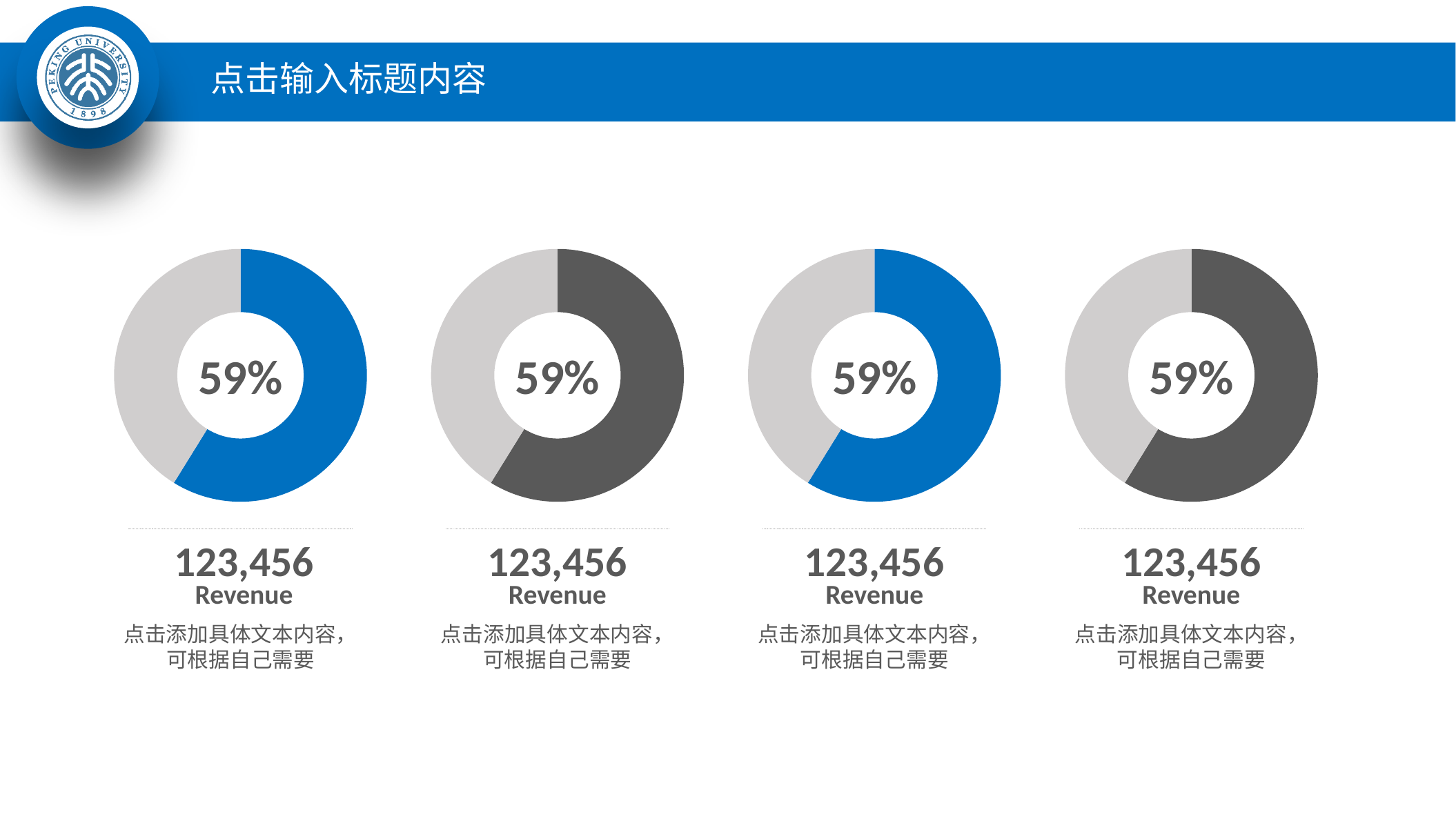
Do the four donut charts show the same percentage or different percentages? The same (59%) What percentage is shown in the centre of the second donut chart from the left? 59% How many donut charts are on the slide? 4 In the leftmost donut chart, is the highlighted share greater or less than 50%? greater What colour is the highlighted segment in the leftmost donut chart? Blue What kind of chart is used four times across the slide? Donut chart What revenue figure is printed below the leftmost donut chart? 123,456 What revenue figure is printed below the third donut chart from the left? 123,456 What colour is the highlighted segment in the rightmost donut chart? Dark grey What percentage is shown in the centre of the rightmost donut chart? 59% What label appears under the revenue figure beneath each donut chart? Revenue What percentage is shown in the centre of the leftmost donut chart? 59%